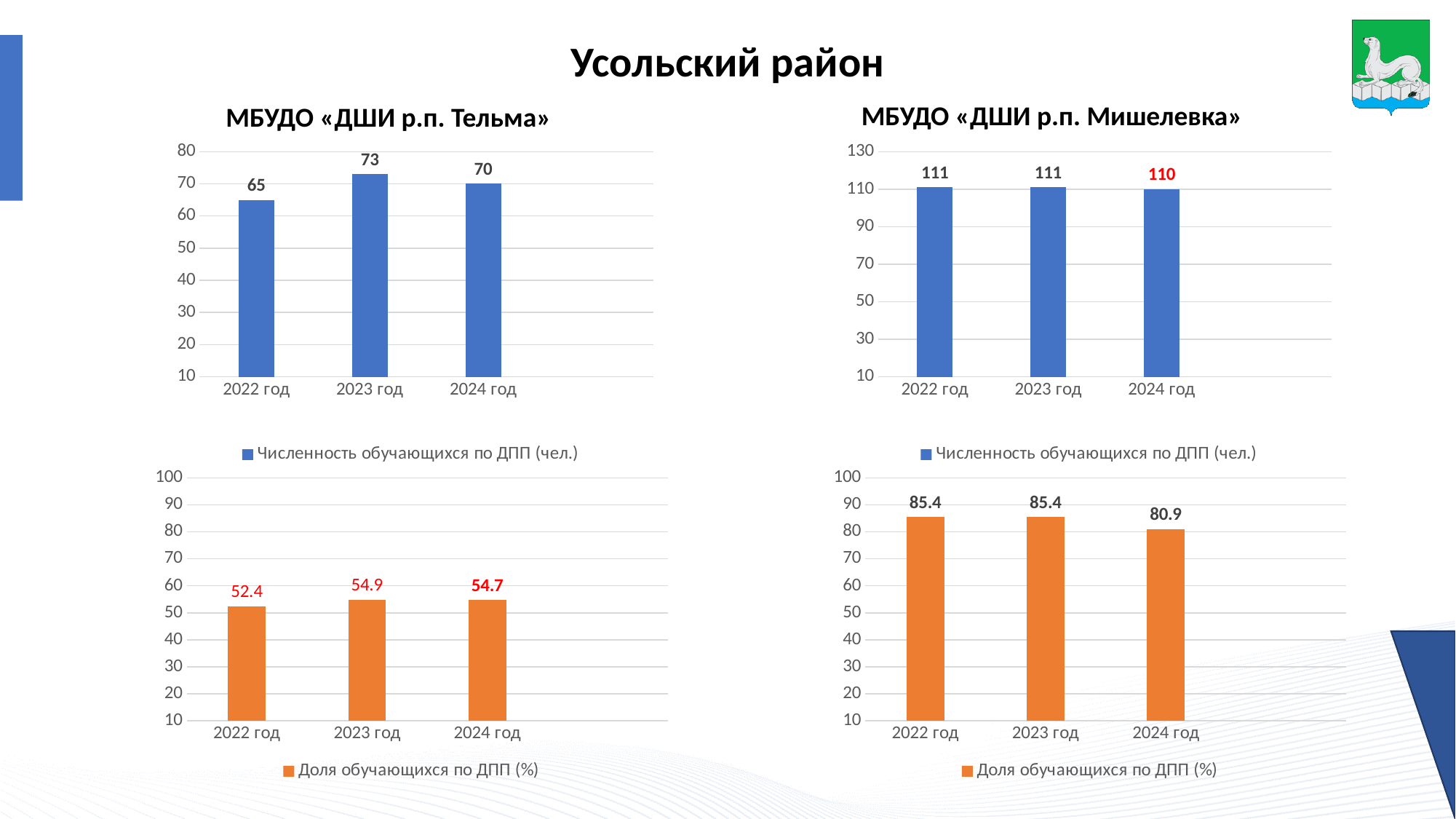
Which is larger: the 2024 год value in the bottom-left chart (Тельма, Доля обучающихся по ДПП) or the 2024 год value in the bottom-right chart (Мишелевка, Доля обучающихся по ДПП)? Мишелевка (80.9) In the bottom-right chart (МБУДО «ДШИ р.п. Мишелевка», Доля обучающихся по ДПП), what is the value for 2024 год? 80.9 What type of chart is the top-left chart (МБУДО «ДШИ р.п. Тельма», Численность обучающихся по ДПП)? Bar chart In the top-right chart (МБУДО «ДШИ р.п. Мишелевка», Численность обучающихся по ДПП), what is the value for 2024 год? 110 What is the legend entry of the bottom-right chart under МБУДО «ДШИ р.п. Мишелевка»? Доля обучающихся по ДПП (%) In the top-left chart (МБУДО «ДШИ р.п. Тельма», Численность обучающихся по ДПП), which year has the lowest value? 2022 год In the top-left chart (МБУДО «ДШИ р.п. Тельма», Численность обучающихся по ДПП), what is the difference between the 2023 год and 2022 год values? 8 In the top-left chart (МБУДО «ДШИ р.п. Тельма», Численность обучающихся по ДПП), what is the value for 2023 год? 73 In the top-right chart (МБУДО «ДШИ р.п. Мишелевка», Численность обучающихся по ДПП), how many years are shown on the x axis? 3 In the bottom-right chart (МБУДО «ДШИ р.п. Мишелевка», Доля обучающихся по ДПП), what is the difference between the 2022 год and 2024 год values? 4.5 In the bottom-left chart (МБУДО «ДШИ р.п. Тельма», Доля обучающихся по ДПП), which year has the highest value? 2023 год In the bottom-left chart (МБУДО «ДШИ р.п. Тельма», Доля обучающихся по ДПП), what is the value for 2022 год? 52.4